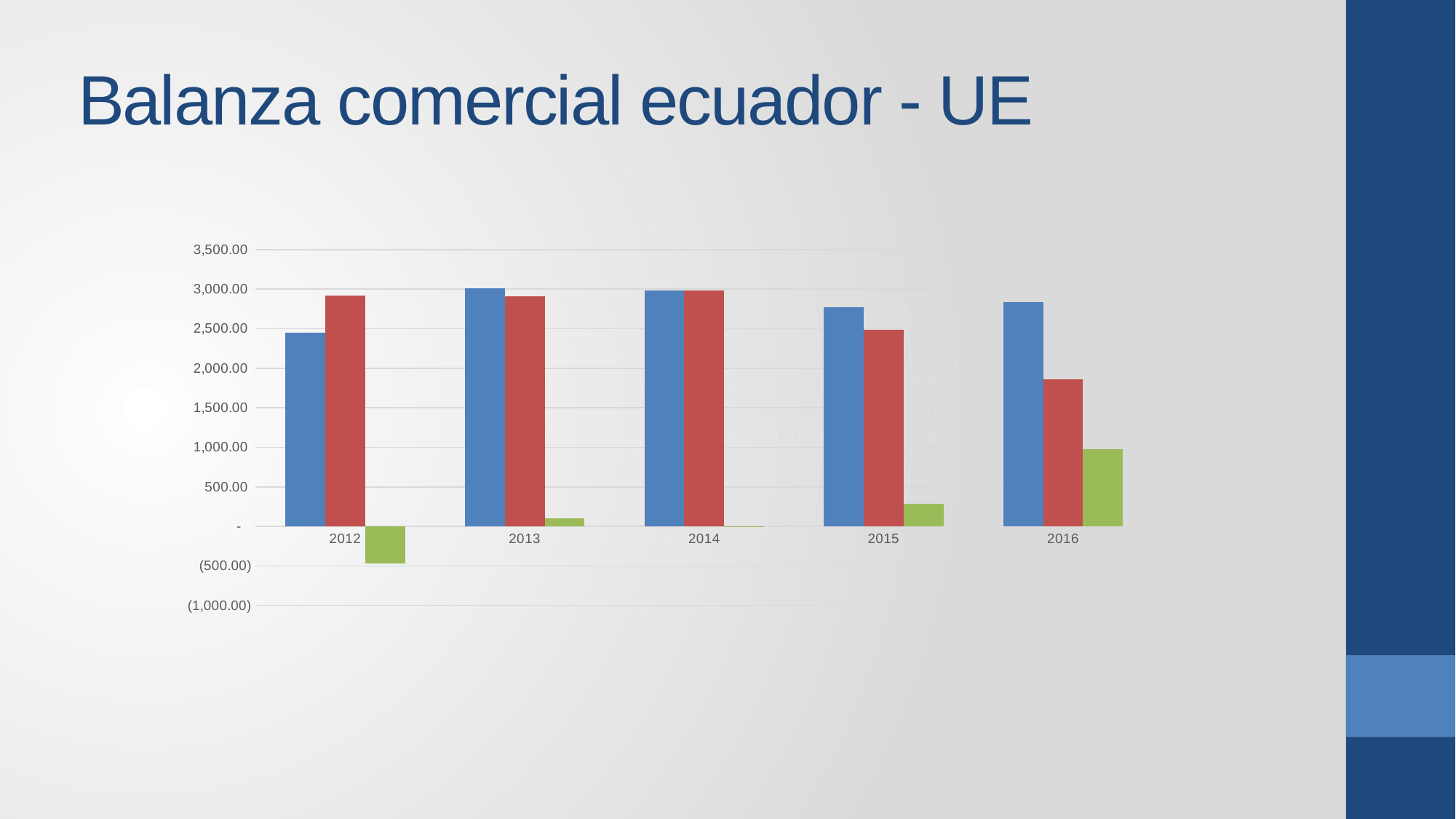
Is the value of the blue bar for 2015 greater or less than 2,500.00? greater Is the value of the green bar for 2016 greater or less than 500.00? greater For 2012, which is larger, the blue bar or the red bar? the red bar For 2016, which is larger, the blue bar or the red bar? the blue bar Is the green bar for 2012 above or below zero? below Do the green bars rise or fall from 2012 to 2016? rise How many years are shown on the x axis of the chart? 5 What kind of chart is shown on the slide? bar chart How many bars are plotted for each year in the chart? 3 What is the title of the slide containing the chart? Balanza comercial ecuador - UE